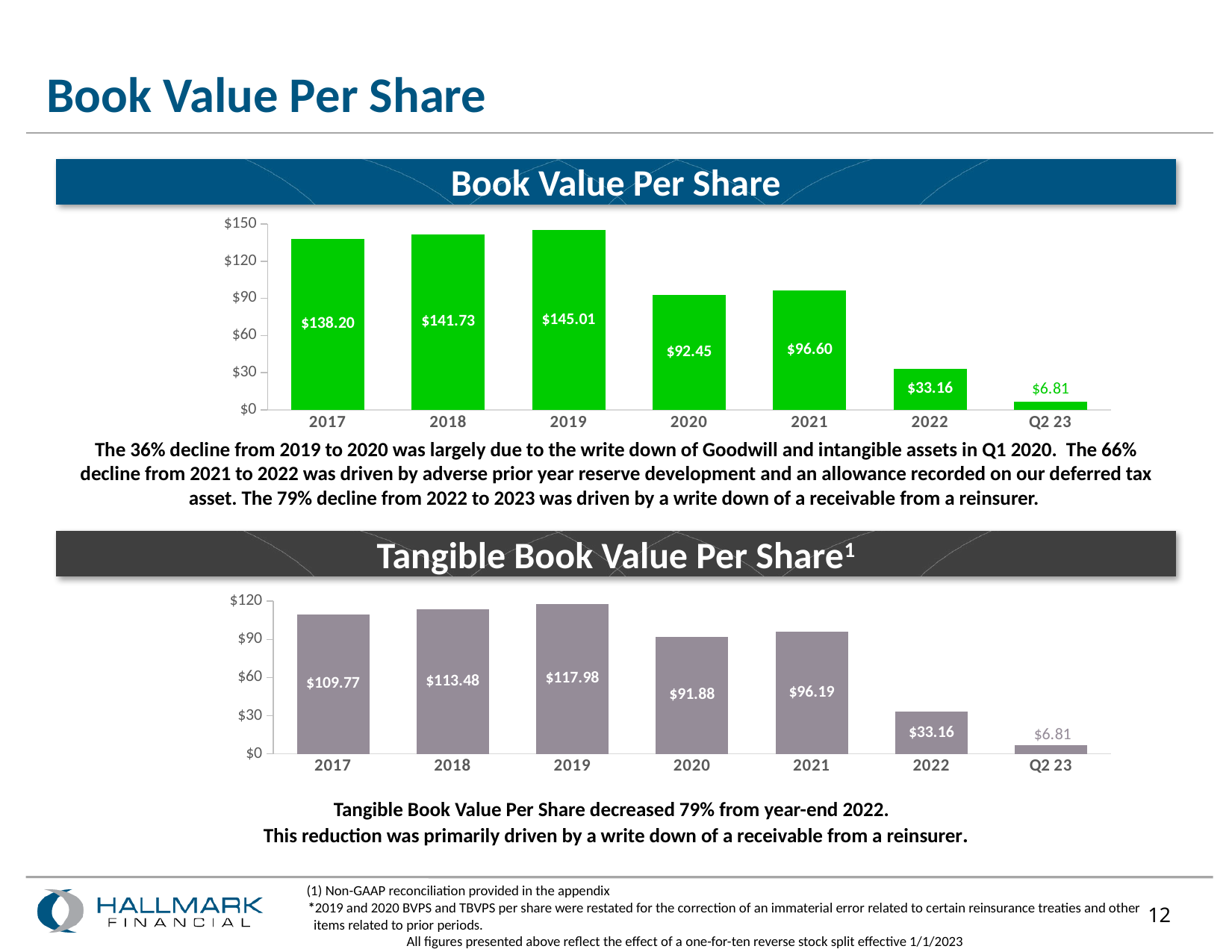
In the Book Value Per Share chart, what is the value for 2019? $145.01 In the Book Value Per Share chart, which year has the highest value? 2019 In the Book Value Per Share chart, is the value for 2020 greater or less than $90? greater In the Tangible Book Value Per Share chart, do the values rise or fall from 2021 to Q2 23? Fall In the Book Value Per Share chart, what is the difference between the 2021 and 2022 values? $63.44 What colour are the bars in the Book Value Per Share chart? Green In the Book Value Per Share chart, which category has the lowest value? Q2 23 In the Tangible Book Value Per Share chart, which is larger, the value for 2020 or the value for 2021? 2021 In the Tangible Book Value Per Share chart, what is the value for 2018? $113.48 What type of chart is the Tangible Book Value Per Share chart? Bar chart In the Tangible Book Value Per Share chart, what is the difference between the 2019 and 2020 values? $26.10 How many categories are shown on the x axis of the Book Value Per Share chart? 7